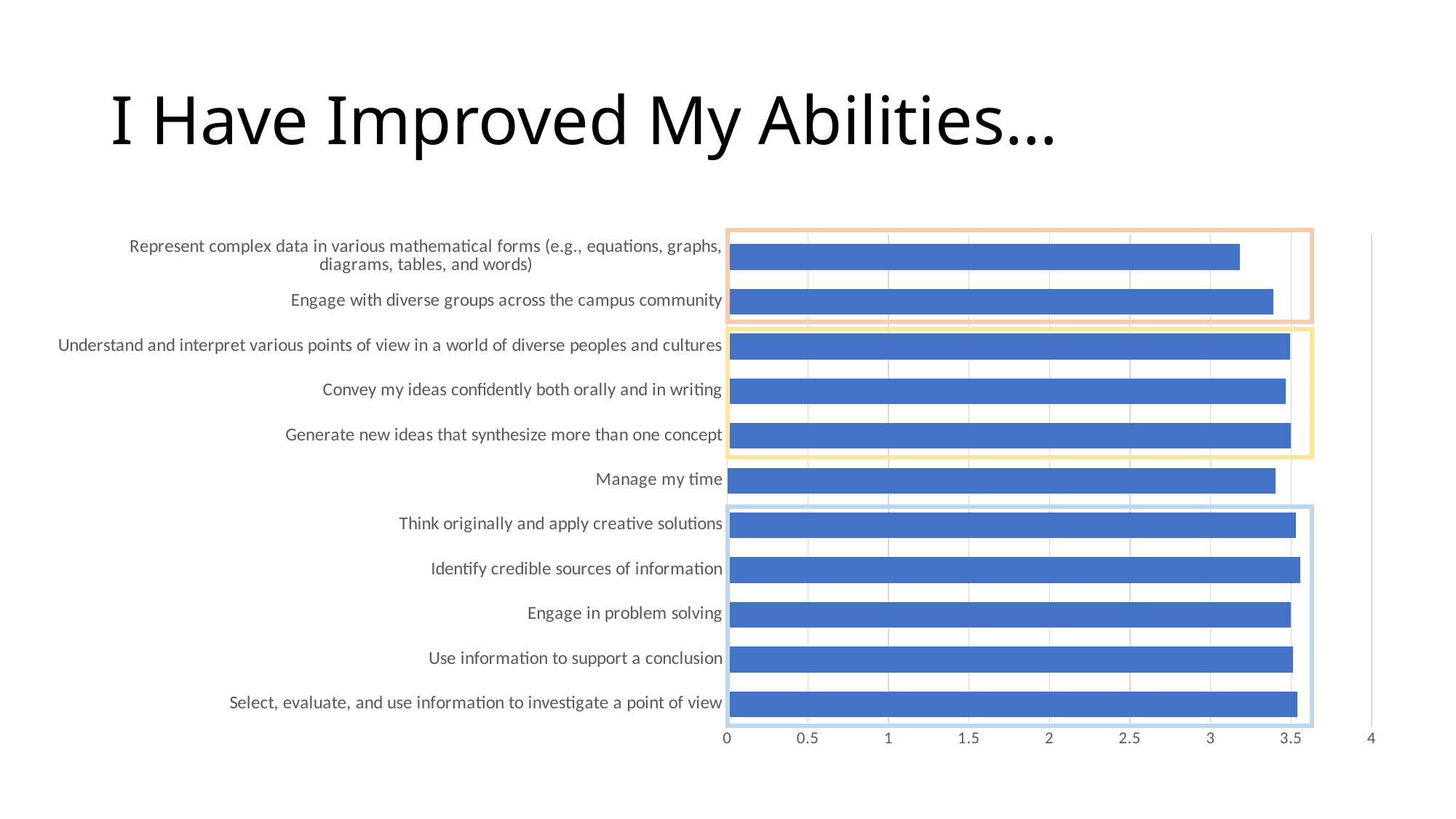
Is the value for "Represent complex data in various mathematical forms" greater or less than 3? greater Is the value for "Represent complex data in various mathematical forms" greater or less than 3.5? less What is the title of the slide containing the chart? I Have Improved My Abilities… Which category has the lowest value in the chart? Represent complex data in various mathematical forms (e.g., equations, graphs, diagrams, tables, and words) What kind of chart is shown on the slide? bar chart How many categories (abilities) are plotted in the chart? 11 Is the value for "Engage with diverse groups across the campus community" greater or less than 3? greater What is the maximum value shown on the horizontal axis of the chart? 4 Which has the larger value: "Manage my time" or "Represent complex data in various mathematical forms"? Manage my time Which has the larger value: "Represent complex data in various mathematical forms" or "Engage with diverse groups across the campus community"? Engage with diverse groups across the campus community